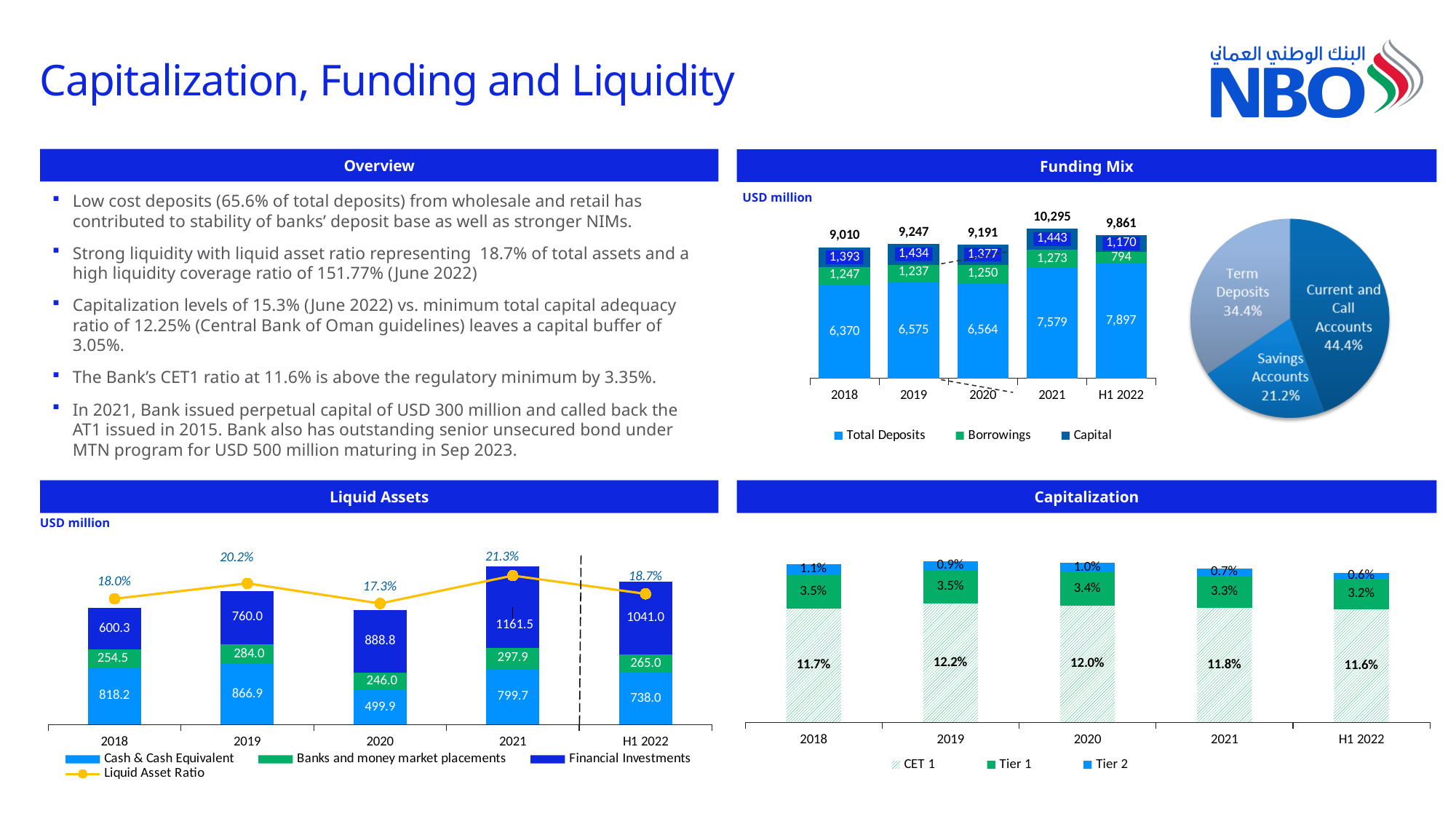
In the Capitalization chart, what is the CET 1 value for 2019? 12.2% In the Funding Mix bar chart, what is the value of Total Deposits for 2021? 7,579 In the Funding Mix bar chart, which year has the highest total shown above the bars? 2021 In the Funding Mix bar chart, how many series does the legend list? 3 In the Liquid Assets chart, what is the Liquid Asset Ratio for 2021? 21.3% In the Liquid Assets chart, what is the total of the stacked bar for 2019? 1910.9 In the Liquid Assets chart, which year has the lowest Cash & Cash Equivalent value? 2020 In the Capitalization chart, how does the Tier 2 value change from 2018 to H1 2022? It falls In the Funding Mix bar chart, what is the difference between the Capital values for 2021 and H1 2022? 273 In the Funding Mix pie chart, which slice is the smallest? Savings Accounts In the Liquid Assets chart, is the Financial Investments value larger in 2020 or in 2021? 2021 In the Funding Mix pie chart, what share do Current and Call Accounts represent? 44.4%